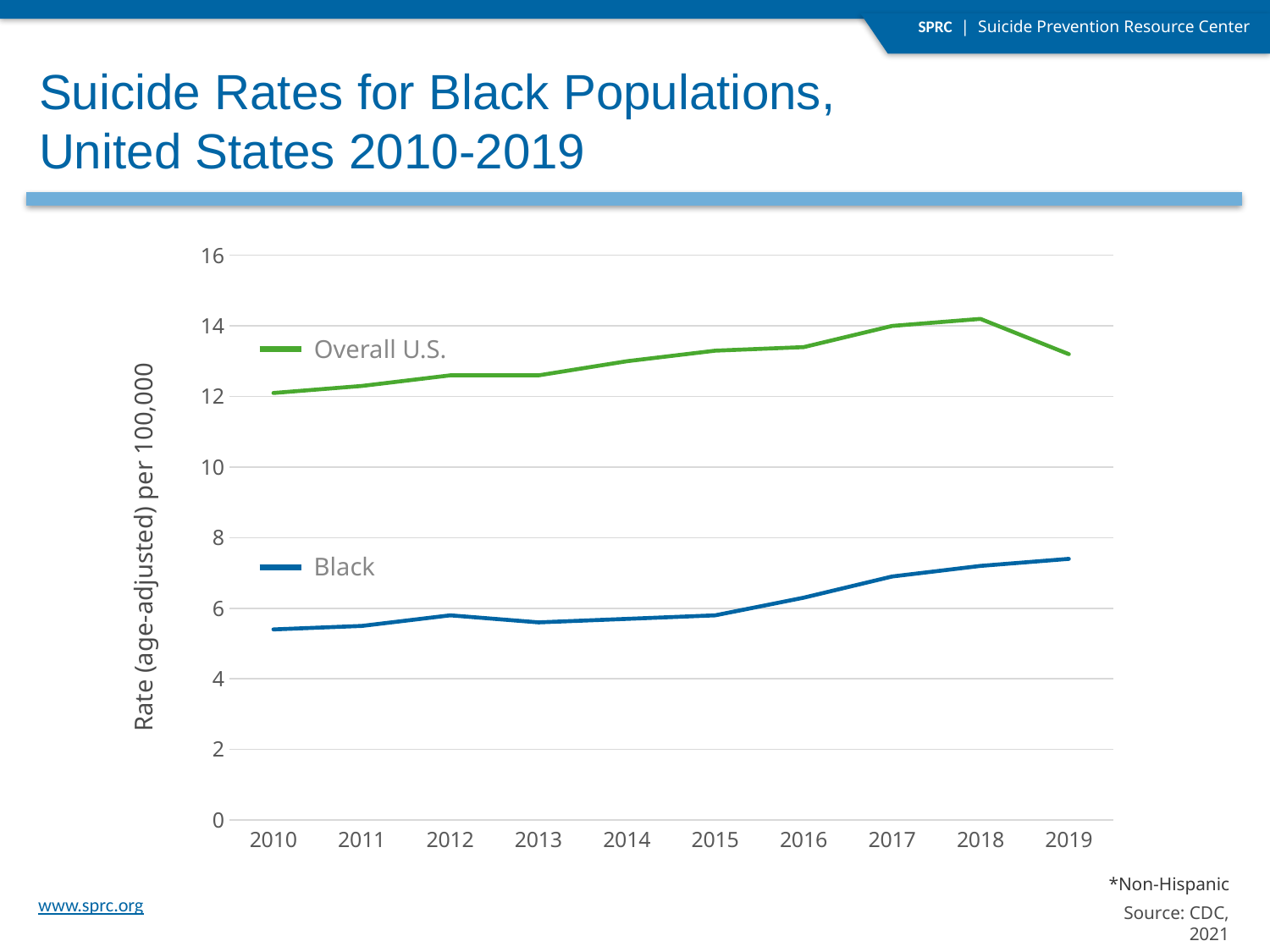
Is the value for Black in 2010 greater or less than 6? less Which two series are labelled on the chart? Overall U.S. and Black What kind of chart is shown on the slide? Line chart Is the value for Black in 2019 greater or less than 6? greater In which year is the Overall U.S. line at its lowest value? 2010 Which series has the higher value in 2015, Overall U.S. or Black? Overall U.S. How many series does the chart show? 2 Is the value for Overall U.S. in 2019 greater or less than 14? less What is the label of the y axis? Rate (age-adjusted) per 100,000 In which year does the Overall U.S. line reach its highest value? 2018 In which year does the Black line reach its highest value? 2019 How many years are plotted along the x axis? 10